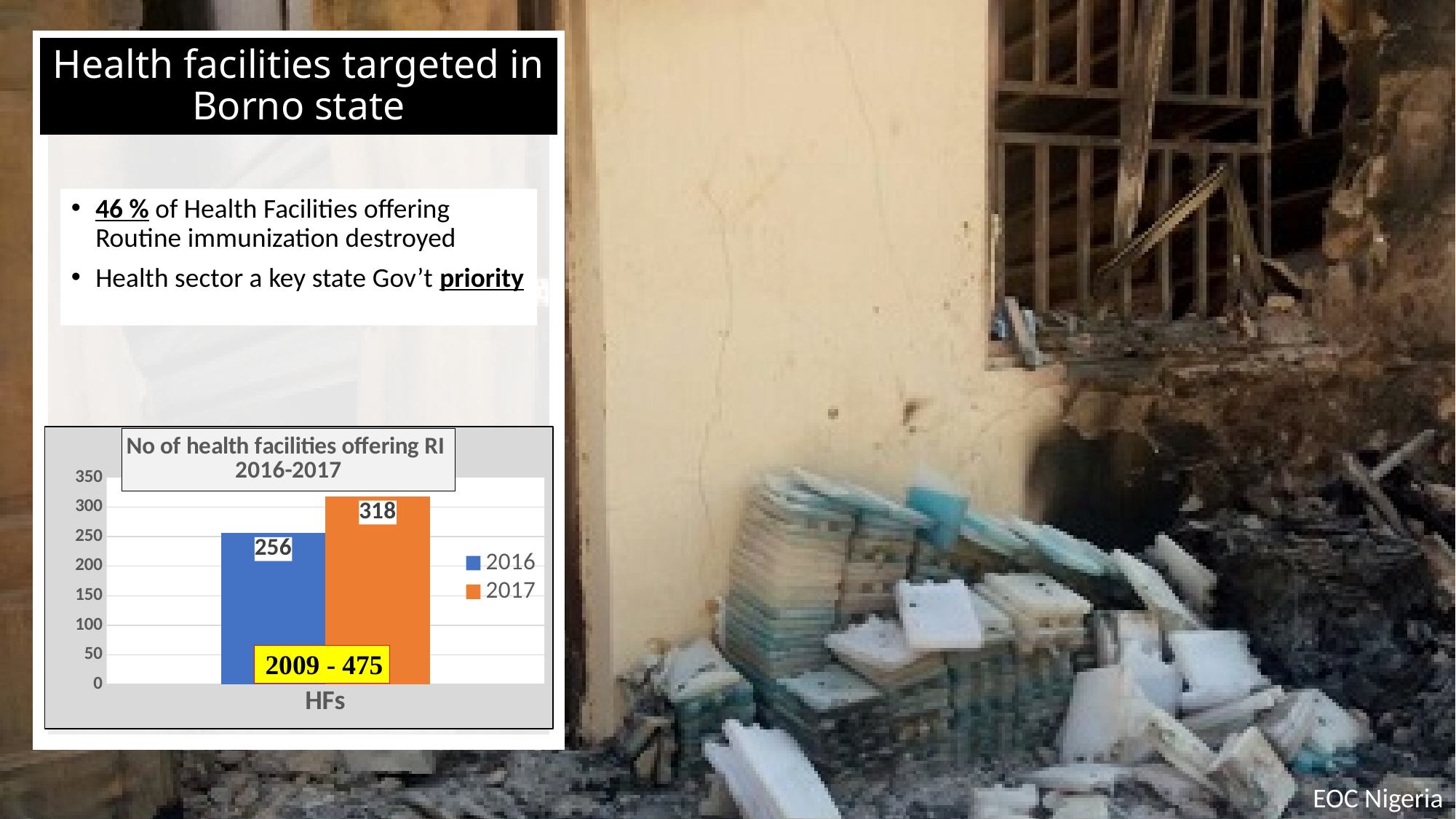
What is the value for 2017 in the chart? 318 What is the difference between the 2017 and 2016 values? 62 Which year has the lower number of health facilities offering RI? 2016 What kind of chart is shown on the slide? bar chart Is the value for 2017 greater or less than 300? greater Is the value for 2016 greater or less than 300? less How many series does the legend list? 2 Which year has the higher number of health facilities offering RI? 2017 What is the title of the chart? No of health facilities offering RI 2016-2017 What is the label on the x axis of the chart? HFs What value is shown in the yellow box for 2009? 475 What is the value for 2016 in the chart? 256